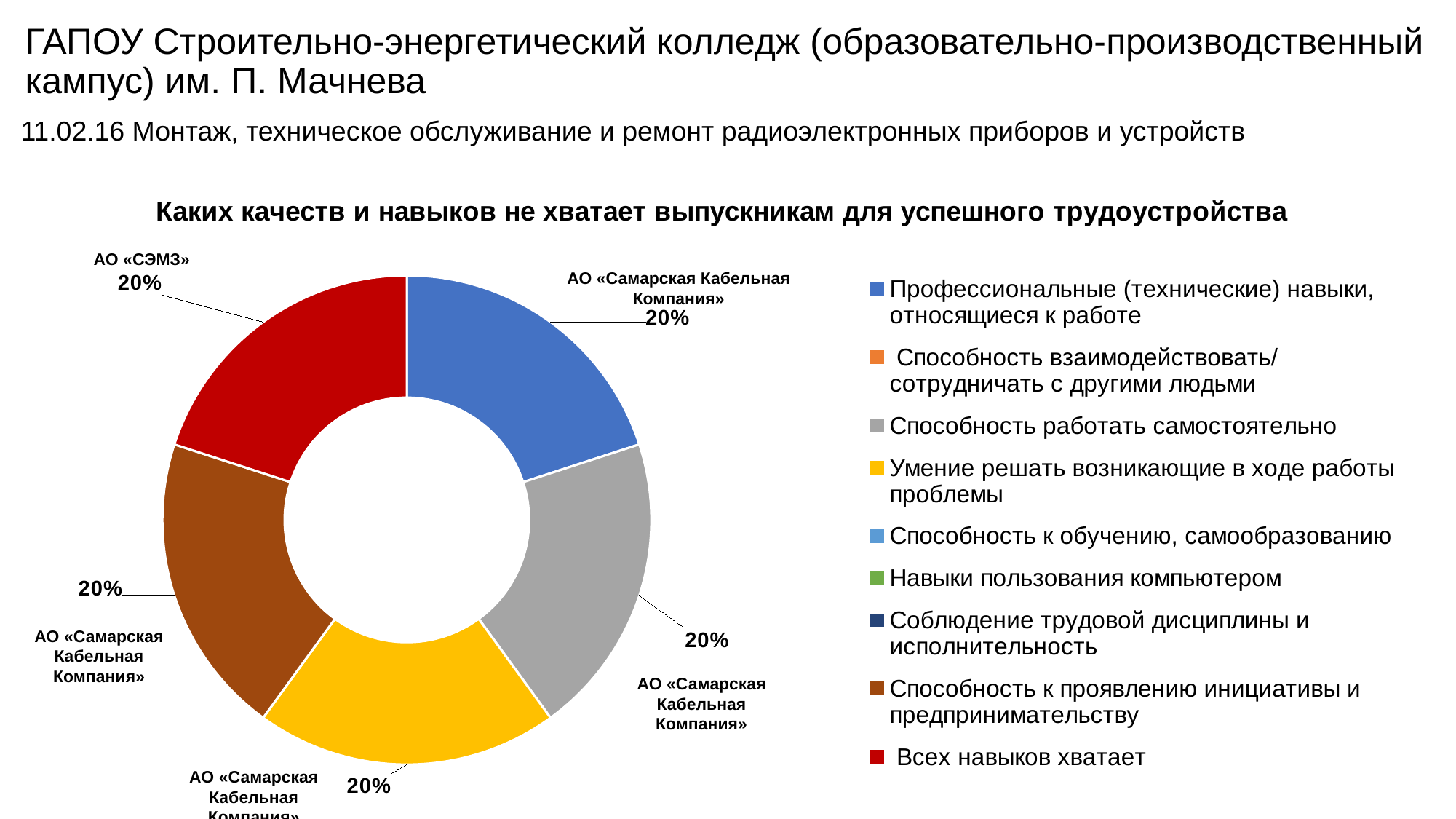
What share of the chart does the slice for «Способность к проявлению инициативы и предпринимательству» (brown) represent? 20% Which organisation is labelled on the red slice of the chart? АО «СЭМЗ» What is the title of the chart? Каких качеств и навыков не хватает выпускникам для успешного трудоустройства How many slices are visible in the doughnut chart? 5 What kind of chart is shown on the slide? doughnut (pie) chart What colour is the slice for «Всех навыков хватает»? red What share of the chart does the slice for «Умение решать возникающие в ходе работы проблемы» (yellow) represent? 20% Which organisation is labelled on the blue slice of the chart? АО «Самарская Кабельная Компания» What share of the chart does the slice for «Всех навыков хватает» (red) represent? 20% How many entries does the chart legend list? 9